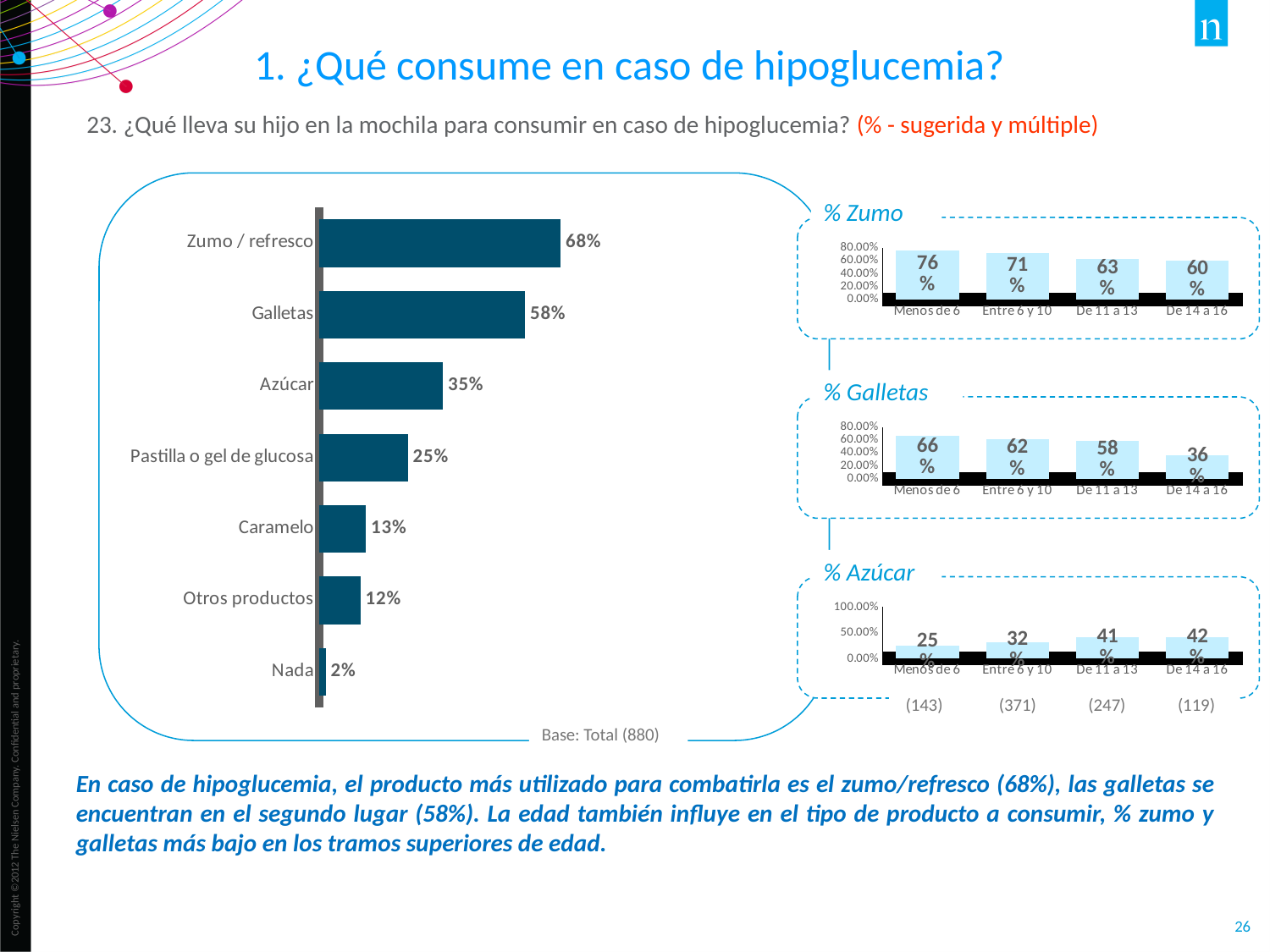
In the '% Azúcar' chart, is the value for Menos de 6 larger or smaller than the value for De 11 a 13? Smaller In the large bar chart on the left, which category has the lowest value? Nada In the large bar chart on the left, what is the value for Galletas? 58% In the '% Zumo' chart, what is the value for De 14 a 16? 60% In the large bar chart on the left, which category has the highest value? Zumo / refresco In the '% Azúcar' chart, which age group has the highest value? De 14 a 16 What kind of chart is the large chart on the left? Bar chart In the '% Zumo' chart, do the values rise or fall from Menos de 6 to De 14 a 16? Fall In the large bar chart on the left, how many categories are shown? 7 In the large bar chart on the left, what is the difference between Zumo / refresco and Azúcar? 33% In the '% Galletas' chart, what is the difference between Menos de 6 and De 14 a 16? 30% In the '% Galletas' chart, what is the value for De 14 a 16? 36%